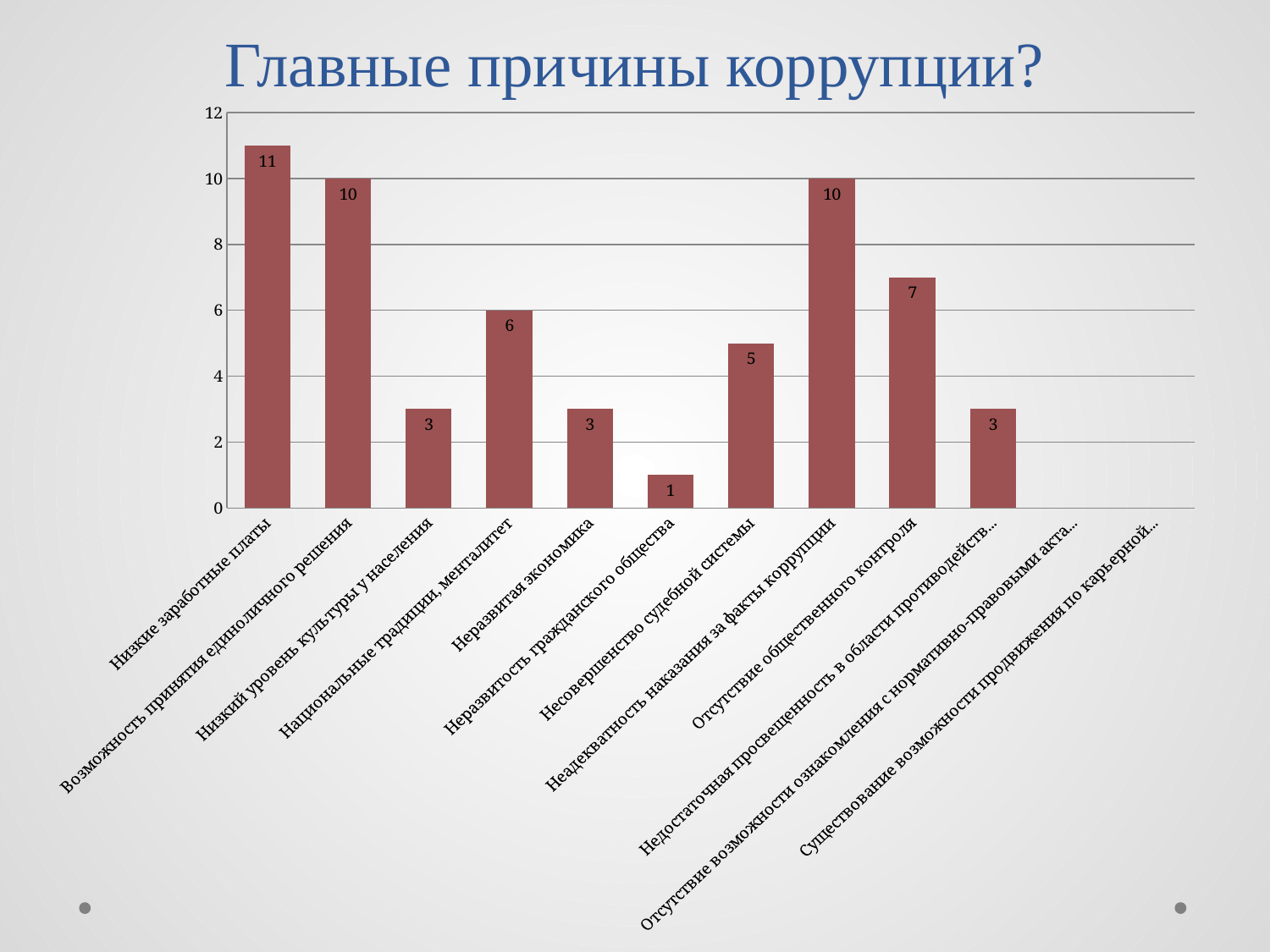
What is the difference between the values for Низкие заработные платы and Возможность принятия единоличного решения? 1 What is the value for Неразвитость гражданского общества? 1 What is the value for Низкие заработные платы? 11 Which category has the highest value? Низкие заработные платы Which category has the shortest visible bar? Неразвитость гражданского общества Which is larger, the value for Национальные традиции, менталитет or the value for Несовершенство судебной системы? Национальные традиции, менталитет What is the difference between the values for Неадекватность наказания за факты коррупции and Отсутствие общественного контроля? 3 What is the title of the slide? Главные причины коррупции? What is the value for Отсутствие общественного контроля? 7 What kind of chart is shown on the slide? bar chart What is the value for Несовершенство судебной системы? 5 Is the value for Неразвитая экономика greater or less than 4? less